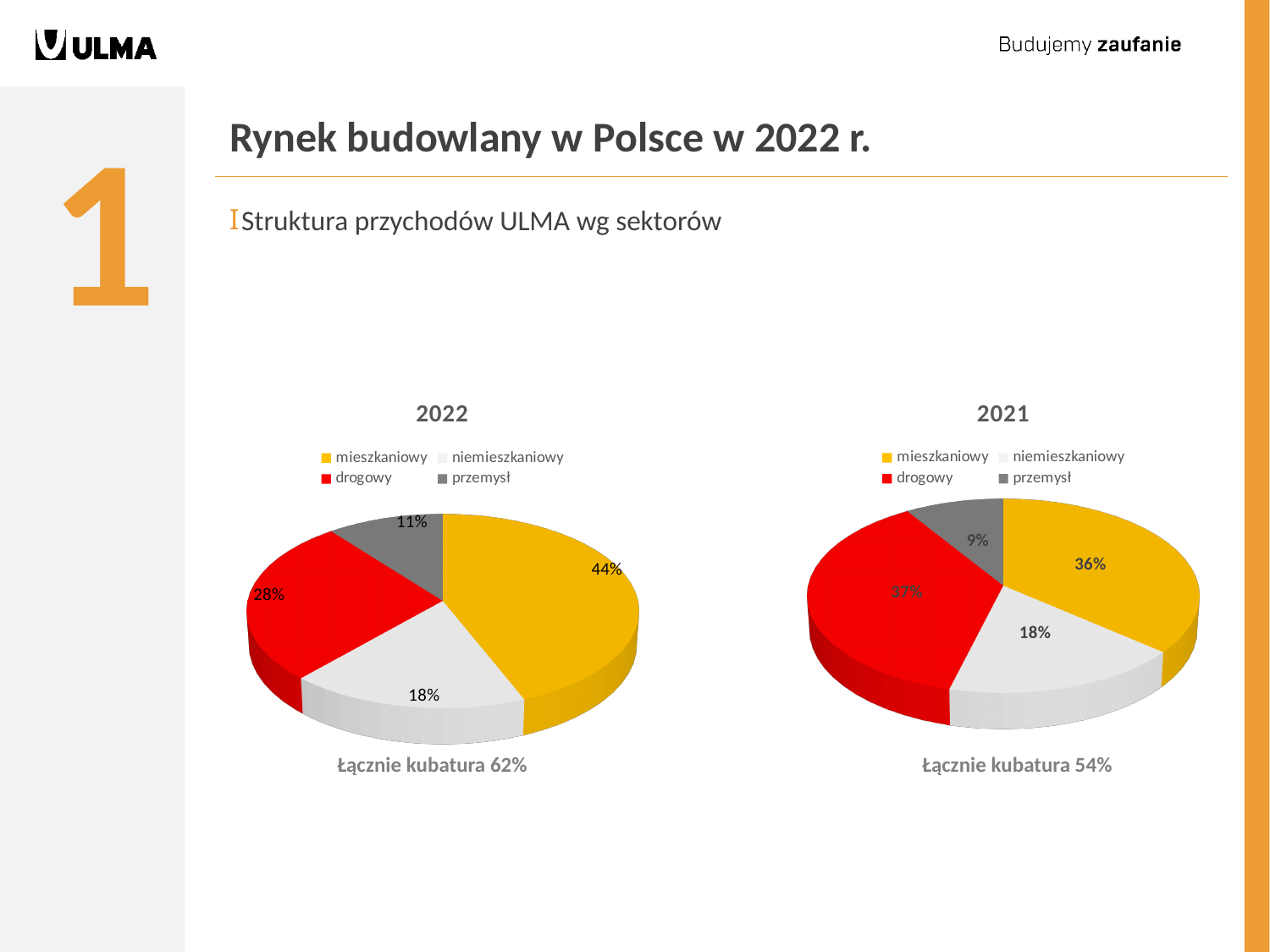
In the 2022 pie chart, what share does the przemysł sector have? 11% How many sectors are shown in the 2022 pie chart? 4 In the 2021 pie chart, what share does the drogowy sector have? 37% In the 2022 pie chart, what is the difference between the mieszkaniowy and drogowy shares? 16 percentage points What is the caption below the 2022 pie chart? Łącznie kubatura 62% Which is larger: the drogowy share in 2022 or the drogowy share in 2021? 2021 In the 2021 pie chart, which sector has the smallest share? przemysł What type of chart is used to show the 2021 revenue structure? pie chart In the 2022 pie chart, what share does the mieszkaniowy sector have? 44% In the 2022 pie chart, which sector has the largest share? mieszkaniowy In the 2021 pie chart, what share does the niemieszkaniowy sector have? 18% In the 2021 pie chart, which sector has the largest share? drogowy